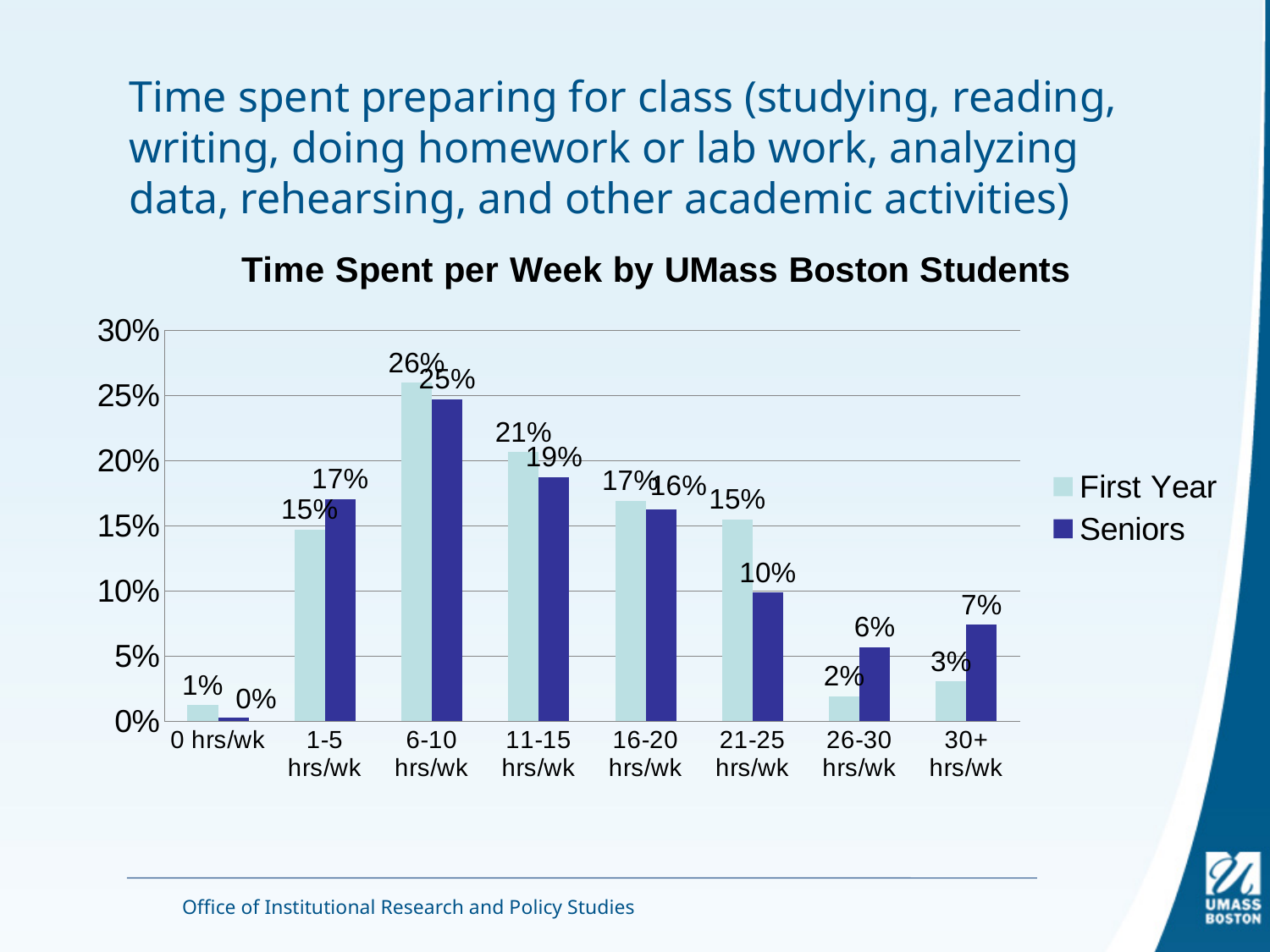
How many series does the legend list? 2 What percentage of First Year students spend 6-10 hrs/wk preparing for class? 26% What percentage of Seniors spend 30+ hrs/wk preparing for class? 7% Is the value for First Year students in the 11-15 hrs/wk category greater or less than 20%? greater How many time categories are shown on the x axis? 8 Which time category has the lowest value for First Year students? 0 hrs/wk What is the difference between First Year and Seniors for the 21-25 hrs/wk category? 5% What kind of chart is shown on the slide? Bar chart Which time category has the highest value for Seniors? 6-10 hrs/wk What percentage of Seniors spend 21-25 hrs/wk preparing for class? 10% What is the title of the chart? Time Spent per Week by UMass Boston Students Which is larger for the 26-30 hrs/wk category, First Year or Seniors? Seniors